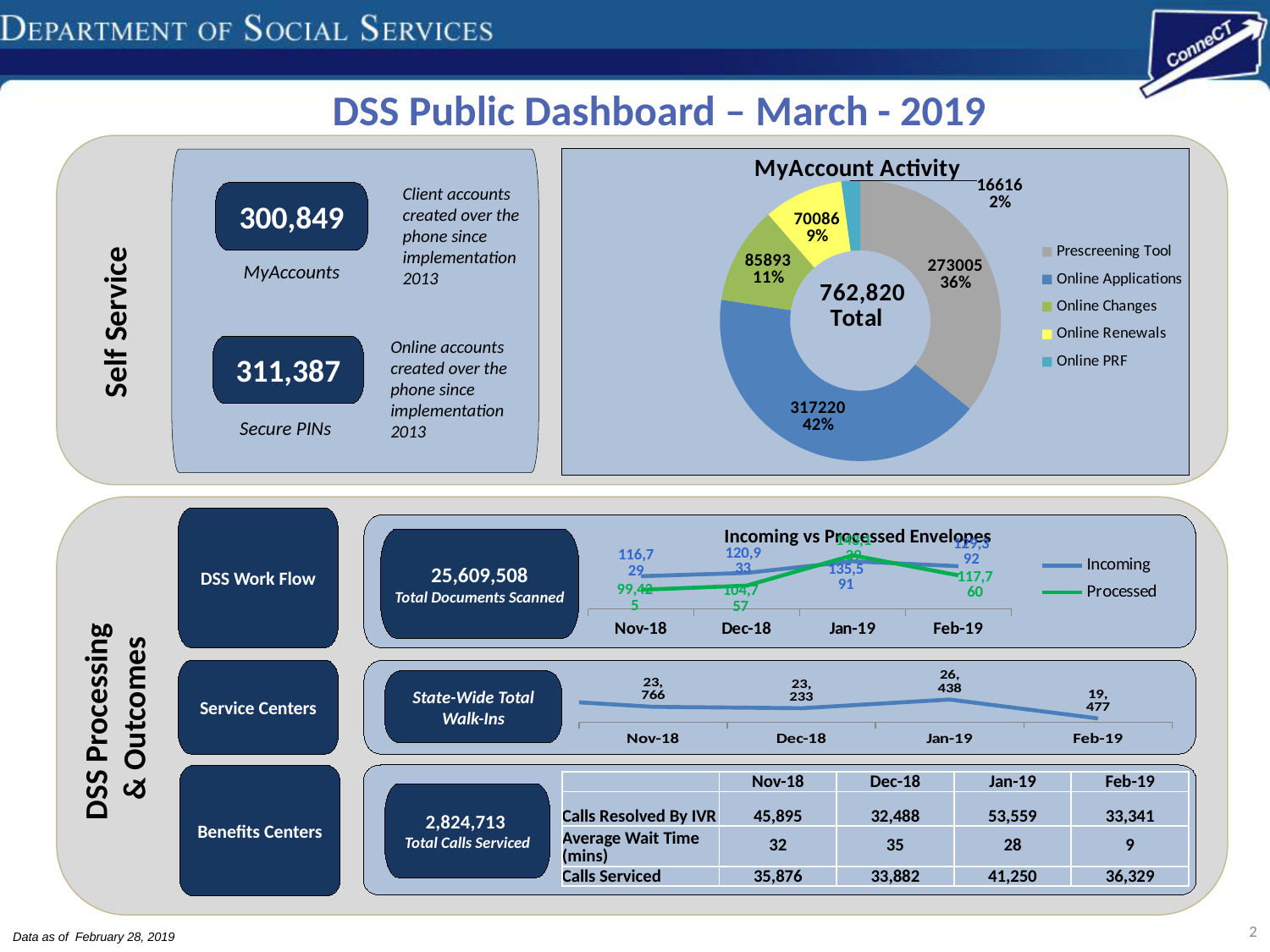
What total is printed in the centre of the MyAccount Activity chart? 762,820 Total In the MyAccount Activity chart, which category has the largest value? Online Applications In the MyAccount Activity chart, what value is shown for Online Applications? 317220 In the MyAccount Activity chart, what is the difference between the Online Changes value and the Online Renewals value? 15807 In the Incoming vs Processed Envelopes chart, which series is higher at Nov-18, Incoming or Processed? Incoming In the MyAccount Activity chart, what percentage share does the Prescreening Tool have? 36% How many series does the legend of the Incoming vs Processed Envelopes chart list? 2 What kind of chart is the Incoming vs Processed Envelopes chart? Line chart In the MyAccount Activity chart, which category has the smallest value? Online PRF In the State-Wide Total Walk-Ins chart, what is the value for Feb-19? 19,477 In the State-Wide Total Walk-Ins chart, which month has the highest value? Jan-19 How many entries does the legend of the MyAccount Activity chart list? 5